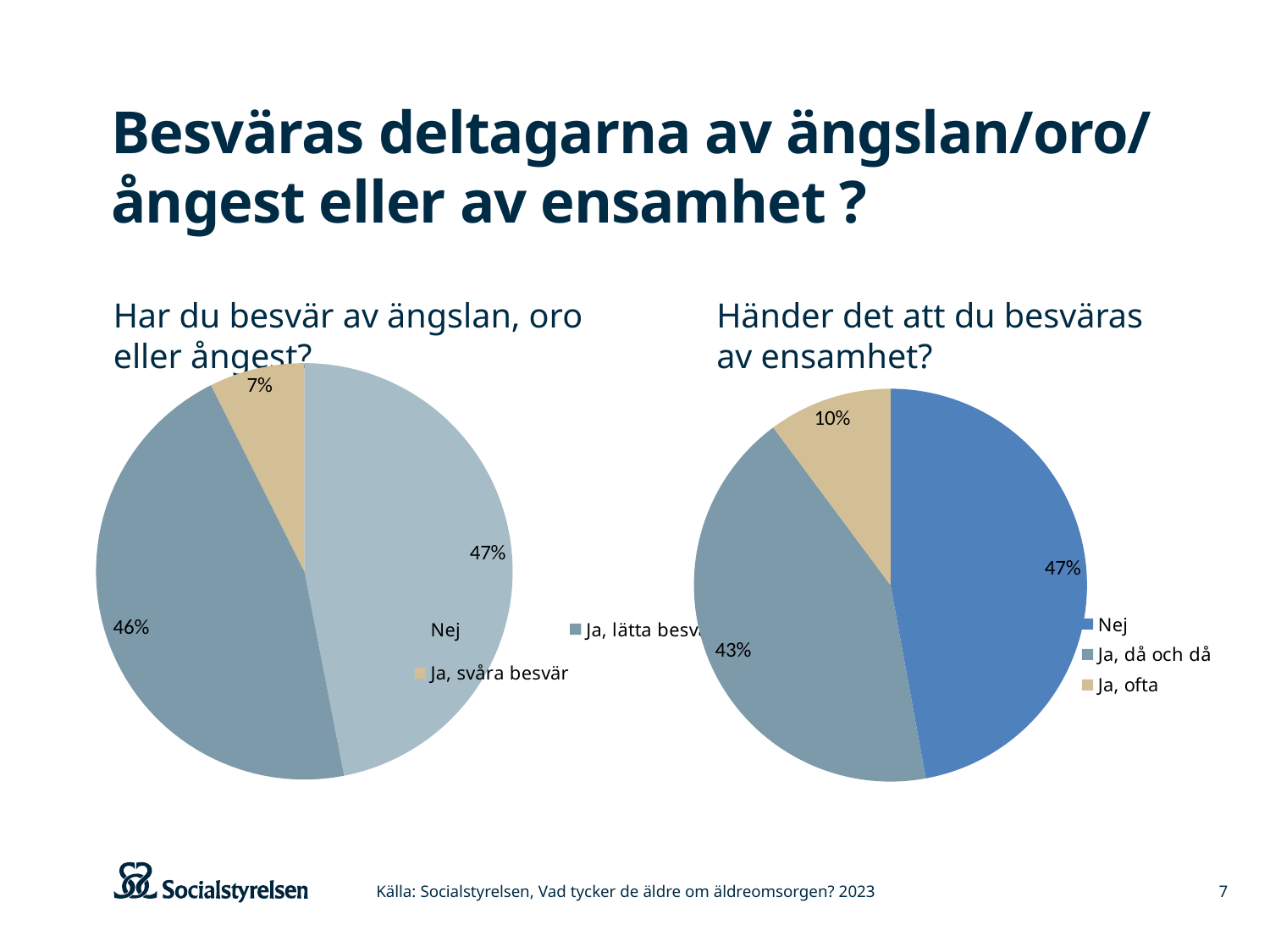
In the left pie chart (Har du besvär av ängslan, oro eller ångest?), what share of respondents answered Nej? 47% In the right pie chart (Händer det att du besväras av ensamhet?), which category has the largest share? Nej How many entries does the legend of the right pie chart (Händer det att du besväras av ensamhet?) list? 3 In the right pie chart (Händer det att du besväras av ensamhet?), what share answered Ja, då och då? 43% In the left pie chart (Har du besvär av ängslan, oro eller ångest?), which category has the smallest share? Ja, svåra besvär How many slices does the right pie chart (Händer det att du besväras av ensamhet?) have? 3 In the left pie chart (Har du besvär av ängslan, oro eller ångest?), what share answered Ja, svåra besvär? 7% In the right pie chart (Händer det att du besväras av ensamhet?), what is the difference in percentage points between Nej and Ja, då och då? 4 percentage points In the right pie chart (Händer det att du besväras av ensamhet?), which is larger: Nej or Ja, ofta? Nej In the right pie chart (Händer det att du besväras av ensamhet?), which category has the smallest share? Ja, ofta What type of chart is used on the left side of the slide? Pie chart In the right pie chart (Händer det att du besväras av ensamhet?), what share answered Ja, ofta? 10%